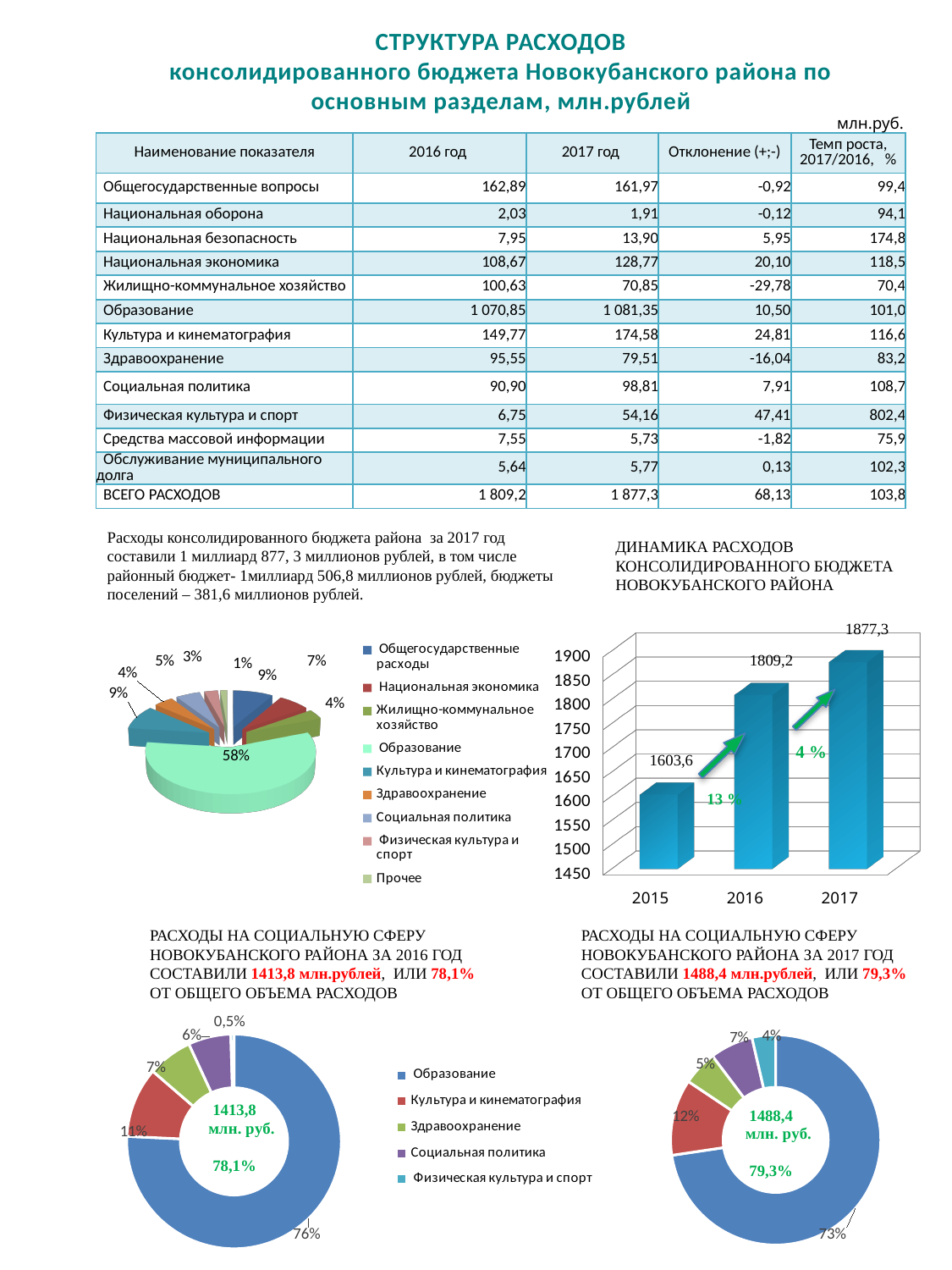
Which is larger: the share of 'Здравоохранение' in the 2016 donut chart (bottom left) or in the 2017 donut chart (bottom right)? 2016 In the donut chart for social sphere expenditures in 2016 (bottom left), what share does 'Образование' have? 76% In the bar chart 'ДИНАМИКА РАСХОДОВ КОНСОЛИДИРОВАННОГО БЮДЖЕТА НОВОКУБАНСКОГО РАЙОНА', what is the value for 2017? 1877,3 In the bar chart 'ДИНАМИКА РАСХОДОВ КОНСОЛИДИРОВАННОГО БЮДЖЕТА НОВОКУБАНСКОГО РАЙОНА', do the values rise or fall from 2015 to 2017? rise In the pie chart on the left of the middle section, what share does 'Образование' have? 58% In the donut chart for social sphere expenditures in 2016 (bottom left), what share does 'Физическая культура и спорт' have? 0,5% What kind of chart is 'ДИНАМИКА РАСХОДОВ КОНСОЛИДИРОВАННОГО БЮДЖЕТА НОВОКУБАНСКОГО РАЙОНА'? bar chart In the bar chart 'ДИНАМИКА РАСХОДОВ КОНСОЛИДИРОВАННОГО БЮДЖЕТА НОВОКУБАНСКОГО РАЙОНА', what is the value for 2015? 1603,6 How many entries does the legend of the pie chart on the left of the middle section list? 9 In the bar chart 'ДИНАМИКА РАСХОДОВ КОНСОЛИДИРОВАННОГО БЮДЖЕТА НОВОКУБАНСКОГО РАЙОНА', what is the difference between the 2017 and 2016 values? 68,1 In the bar chart 'ДИНАМИКА РАСХОДОВ КОНСОЛИДИРОВАННОГО БЮДЖЕТА НОВОКУБАНСКОГО РАЙОНА', which year has the lowest value? 2015